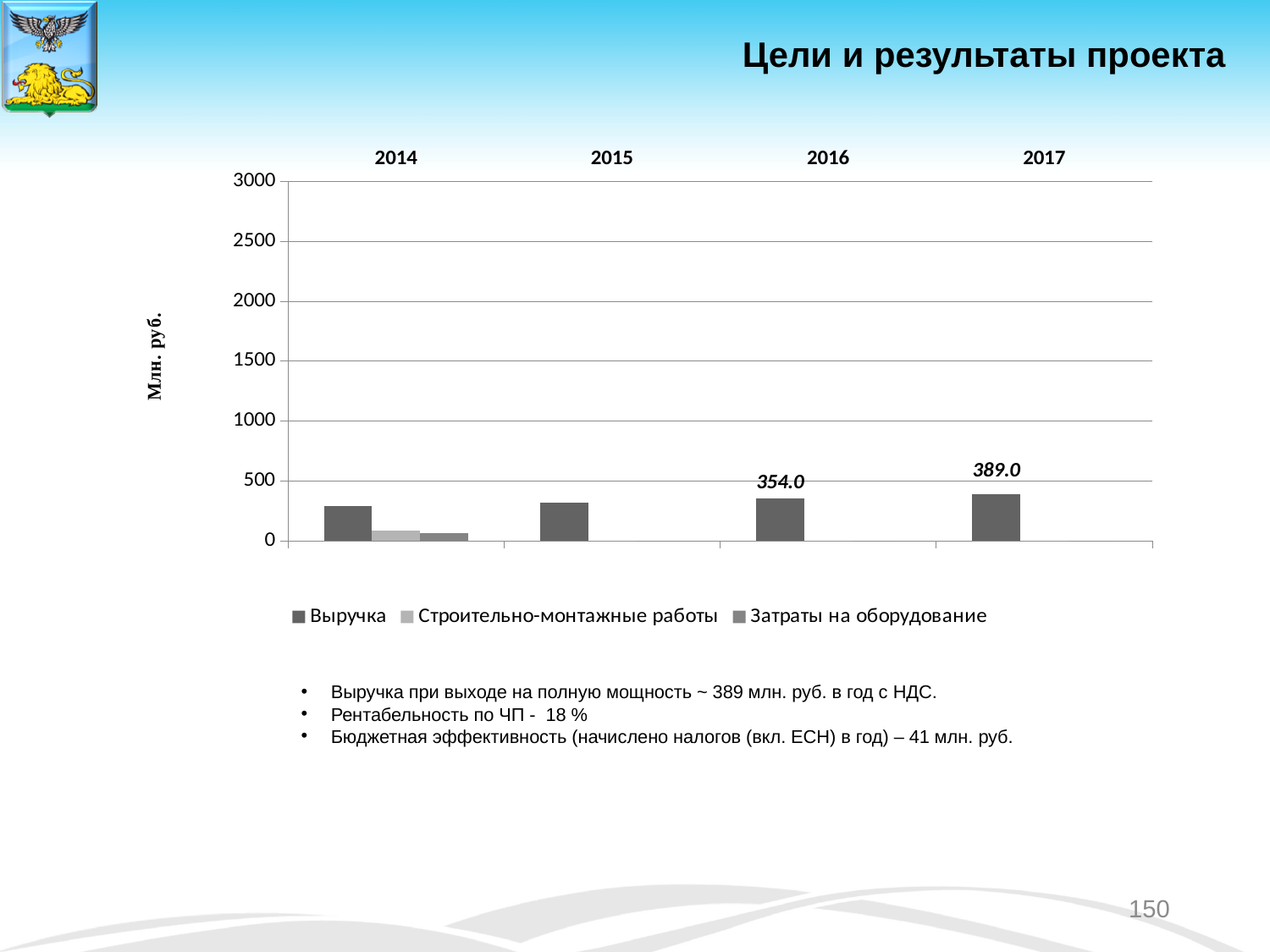
How many years are shown on the x axis of the chart? 4 What is the label of the vertical axis of the chart? Млн. руб. What kind of chart is shown on the slide? bar chart Is the value of Выручка for 2014 greater or less than 500? less Which is larger, the Выручка value for 2016 or for 2017? 2017 Does Выручка rise or fall from 2014 to 2017? rise What is the value of Выручка for 2017? 389.0 What is the value of Выручка for 2016? 354.0 Is the value of Строительно-монтажные работы for 2014 greater or less than 500? less How many series does the legend list? 3 In which year is Выручка highest? 2017 What is the difference between the Выручка values for 2017 and 2016? 35.0